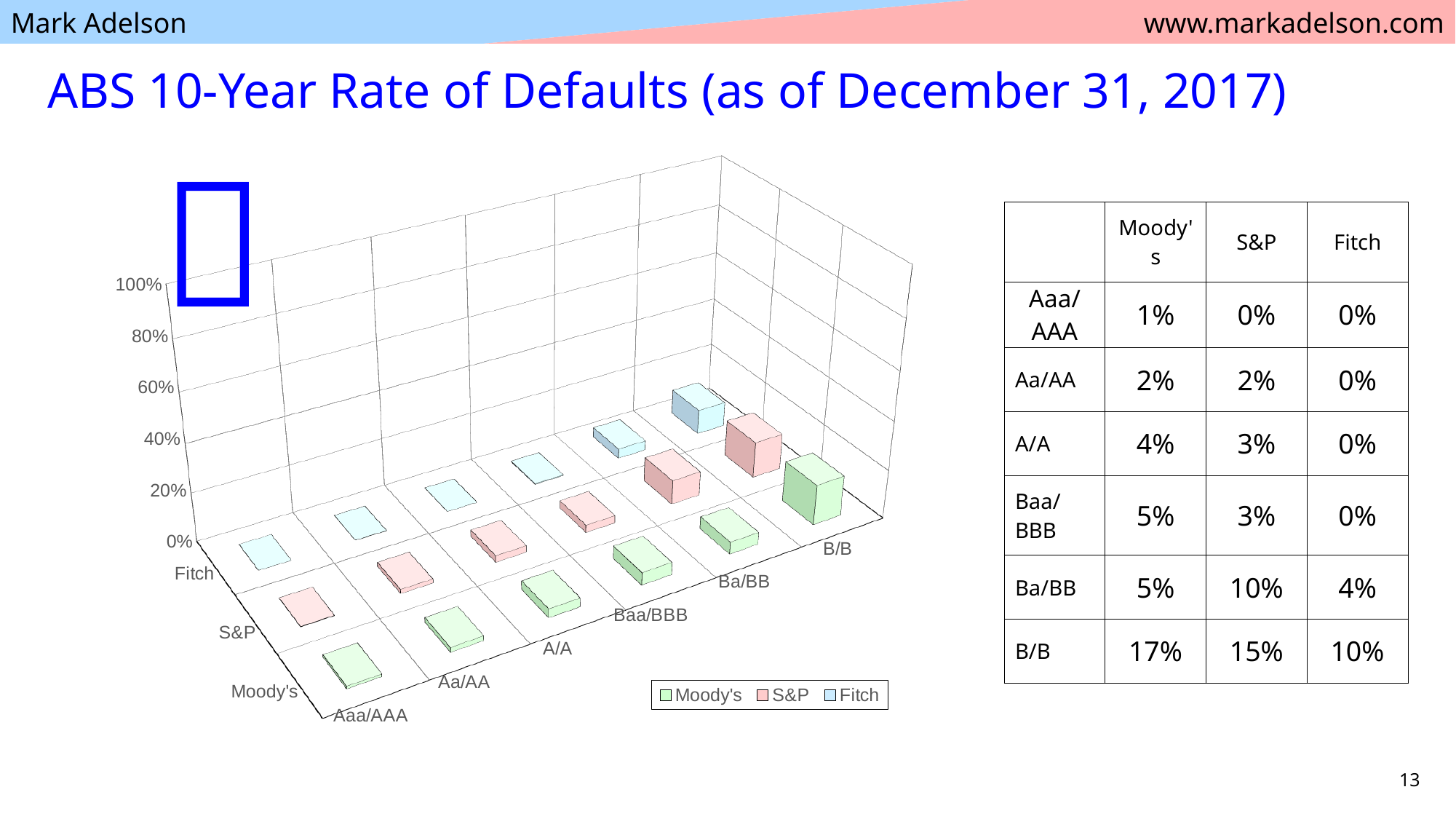
According to the table, what is the Moody's 10-year default rate for B/B? 17% What kind of chart is shown on the slide? bar chart How many series does the chart legend list? 3 Do the Moody's default rates rise or fall as the rating moves from Aaa/AAA to B/B? rise Is the Moody's default rate for B/B greater or less than 20%? less Which rating category has the highest Moody's default rate? B/B According to the table, what is the S&P 10-year default rate for Ba/BB? 10% Which rating agency has the lowest default rate for B/B? Fitch What is the difference between the Moody's and Fitch default rates for B/B? 7% According to the table, what is the Fitch 10-year default rate for Baa/BBB? 0% How many rating categories are plotted along the x axis of the chart? 6 Which is larger, the S&P default rate for Ba/BB or the Moody's default rate for Ba/BB? S&P